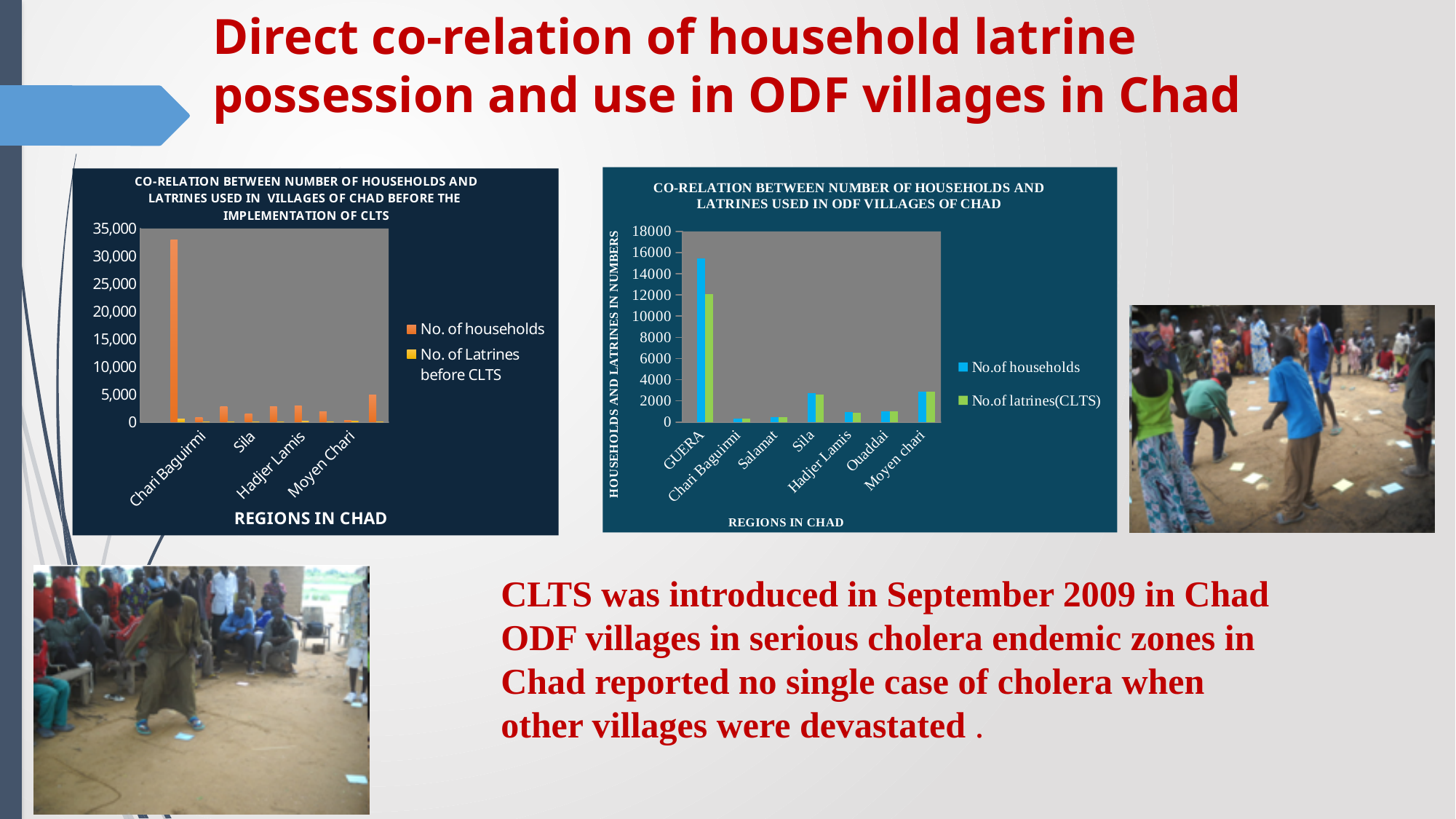
In the chart on the right (ODF villages of Chad), how many series does the legend list? 2 In the chart on the right (ODF villages of Chad), which has more households, GUERA or Sila? GUERA In the chart on the left (before the implementation of CLTS), how many series does the legend list? 2 What kind of chart is the chart on the left (before the implementation of CLTS)? Bar chart In the chart on the right (ODF villages of Chad), is the number of households for GUERA greater or less than 14000? greater In the chart on the right (ODF villages of Chad), which region has the highest number of households? GUERA In the chart on the right (ODF villages of Chad), how many regions are shown on the x axis? 7 In the chart on the right (ODF villages of Chad), what is the title of the y axis? HOUSEHOLDS AND LATRINES IN NUMBERS In the chart on the right (ODF villages of Chad), is the number of households for Chari Baguirmi greater or less than 2000? less In the chart on the left (before the implementation of CLTS), what is the title of the x axis? REGIONS IN CHAD In the chart on the right (ODF villages of Chad), is the number of households for Sila greater or less than 2000? greater What kind of chart is the chart titled 'CO-RELATION BETWEEN NUMBER OF HOUSEHOLDS AND LATRINES USED IN ODF VILLAGES OF CHAD'? Bar chart